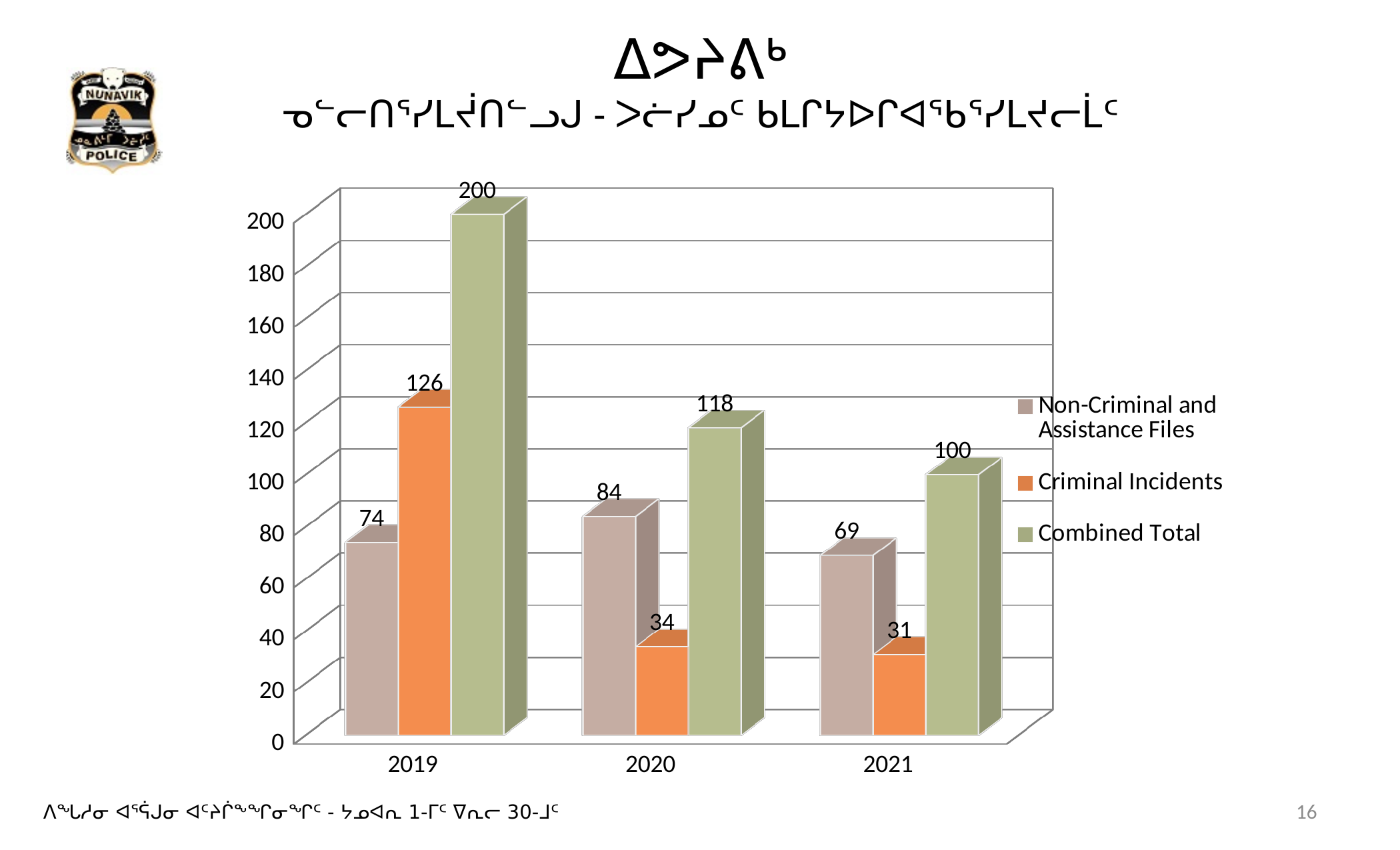
What is the difference between Criminal Incidents in 2019 and in 2020? 92 Which year has the lowest value for Criminal Incidents? 2021 What is the Combined Total for 2021? 100 Which year has the highest Combined Total? 2019 Which is larger in 2020: Non-Criminal and Assistance Files or Criminal Incidents? Non-Criminal and Assistance Files How many years are shown on the x axis? 3 What is the value for Criminal Incidents in 2019? 126 What is the difference between the Combined Total in 2019 and in 2020? 82 Does the Combined Total rise or fall from 2019 to 2021? Fall What is the value for Non-Criminal and Assistance Files in 2020? 84 How many series does the legend list? 3 What kind of chart is shown on the slide? Bar chart